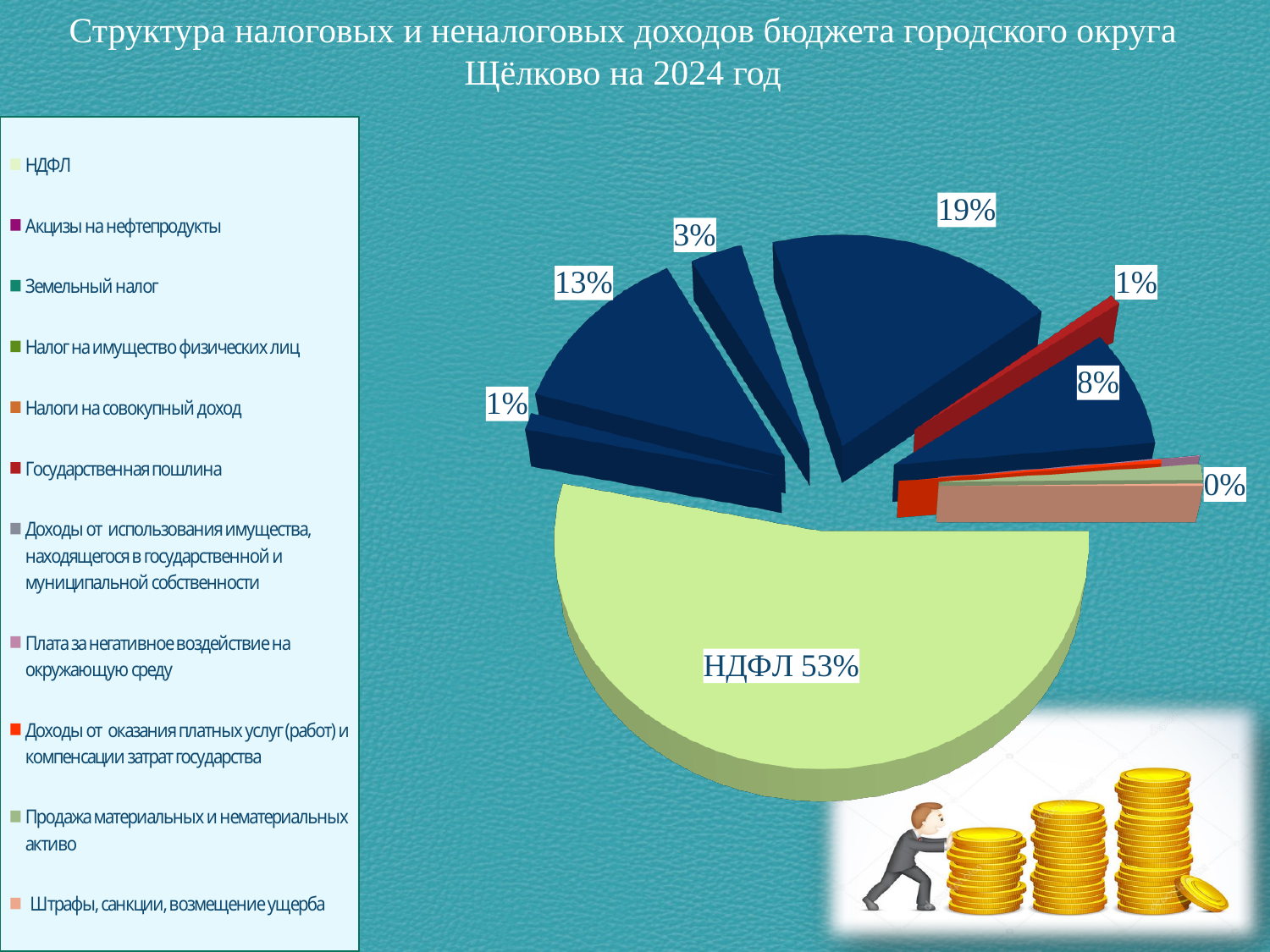
How many percentage data labels are printed on the pie chart? 8 Which entry appears last in the legend? Штрафы, санкции, возмещение ущерба What is the difference in percentage points between the НДФЛ slice (53%) and the slice labelled 19%? 34 Which is larger: the НДФЛ slice or the slice labelled 19%? НДФЛ What kind of chart is shown on the slide? Pie chart Is the share for НДФЛ greater or less than 50%? greater What share of the pie does НДФЛ account for? 53% What is the smallest percentage value printed on the pie chart? 0% What is the title of the chart on the slide? Структура налоговых и неналоговых доходов бюджета городского округа Щёлково на 2024 год Which category has the largest slice of the pie? НДФЛ What is the second-largest percentage value printed on the pie chart? 19% How many entries does the legend list? 11